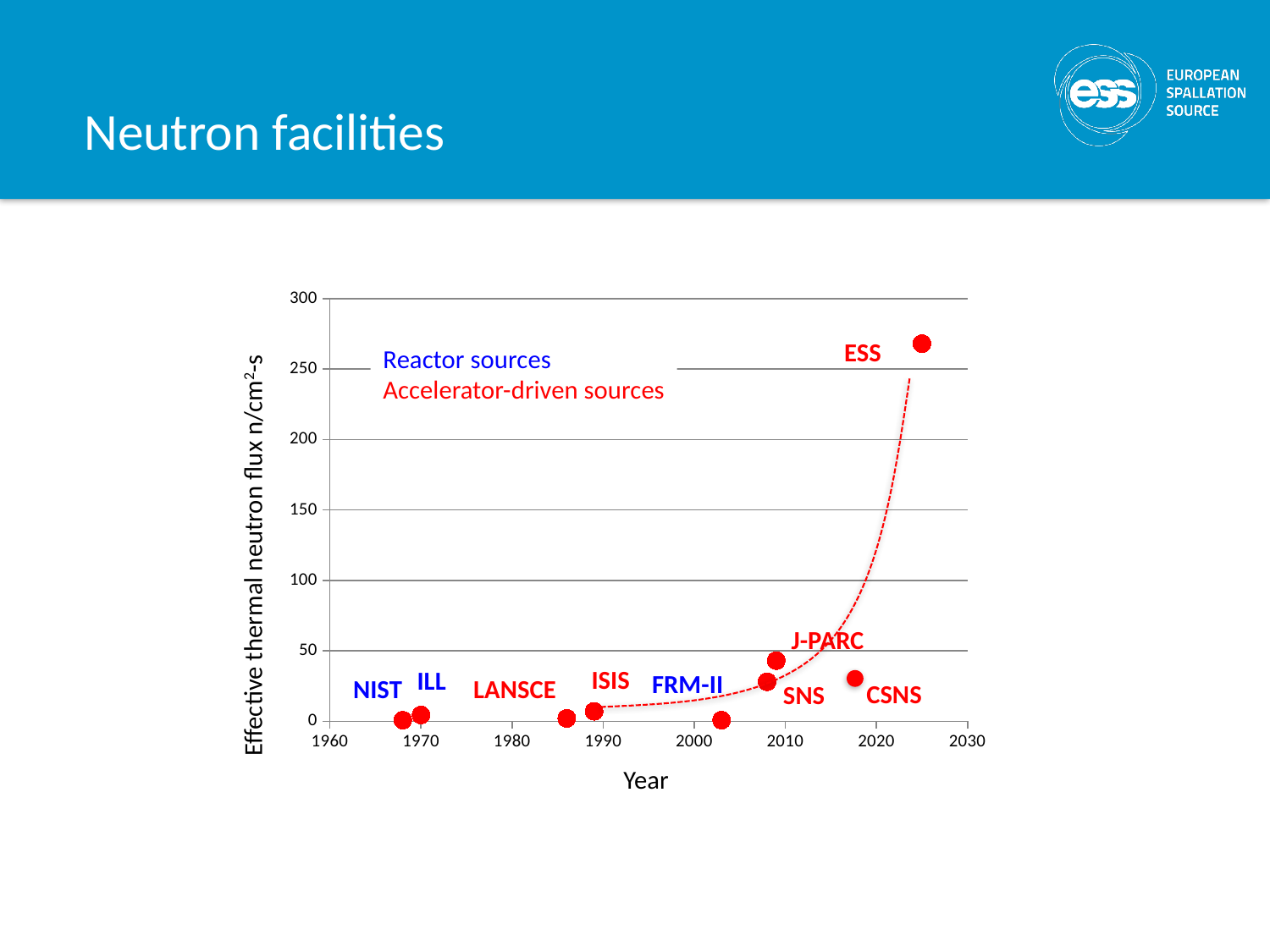
Is the effective thermal neutron flux for ESS greater or less than 250? greater According to the chart's legend, what colour are the labels for reactor sources? blue What is the label of the y axis on the chart? Effective thermal neutron flux n/cm2-s Is the effective thermal neutron flux for J-PARC greater or less than 50? less How many neutron facilities are plotted as points on the chart? 9 Is the effective thermal neutron flux for ISIS greater or less than 50? less What kind of chart is shown on the slide? scatter chart Which has a higher effective thermal neutron flux, ESS or J-PARC? ESS Which has a higher effective thermal neutron flux, J-PARC or SNS? J-PARC Does the effective thermal neutron flux generally rise or fall as the year increases along the x axis? rise Which facility has the highest effective thermal neutron flux on the chart? ESS